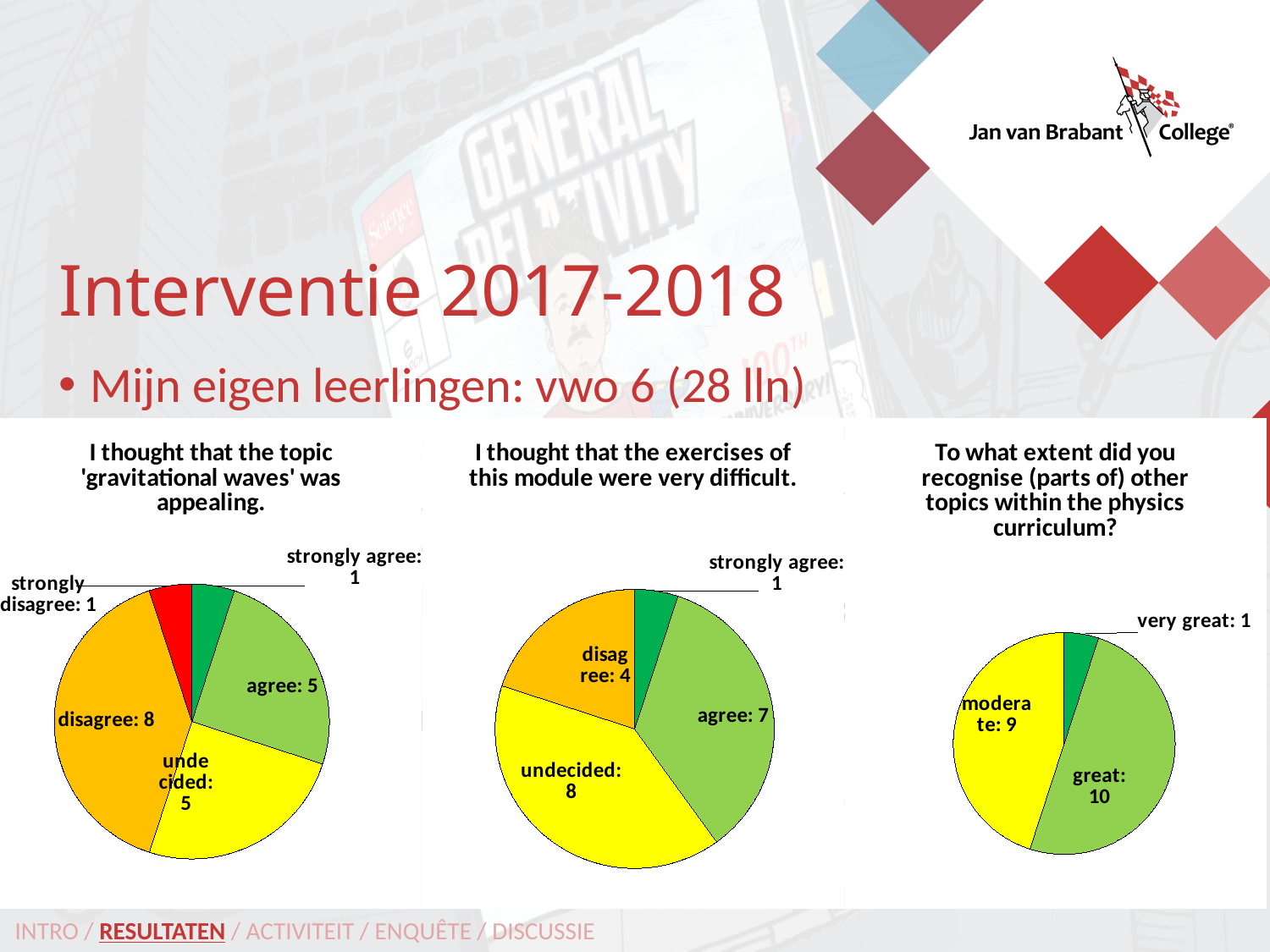
In the chart titled "To what extent did you recognise (parts of) other topics within the physics curriculum?", what share of responses does the "great" slice represent? 50% In the chart titled "I thought that the topic 'gravitational waves' was appealing.", what is the difference between the "disagree" and "agree" counts? 3 In the chart titled "I thought that the exercises of this module were very difficult.", which is larger: "agree" or "disagree"? agree In the chart titled "I thought that the exercises of this module were very difficult.", how many respondents were "undecided"? 8 In the chart titled "I thought that the topic 'gravitational waves' was appealing.", how many respondents chose "disagree"? 8 In the chart titled "I thought that the topic 'gravitational waves' was appealing.", how many slices does the pie have? 5 In the chart titled "I thought that the exercises of this module were very difficult.", which response has the smallest slice? strongly agree In the chart titled "I thought that the topic 'gravitational waves' was appealing.", which response has the largest slice? disagree In the chart titled "I thought that the exercises of this module were very difficult.", what is the total number of responses across all slices? 20 In the chart titled "To what extent did you recognise (parts of) other topics within the physics curriculum?", how many slices does the pie have? 3 In the chart titled "To what extent did you recognise (parts of) other topics within the physics curriculum?", how many respondents answered "great"? 10 What type of chart is used for the three charts on the slide? pie chart